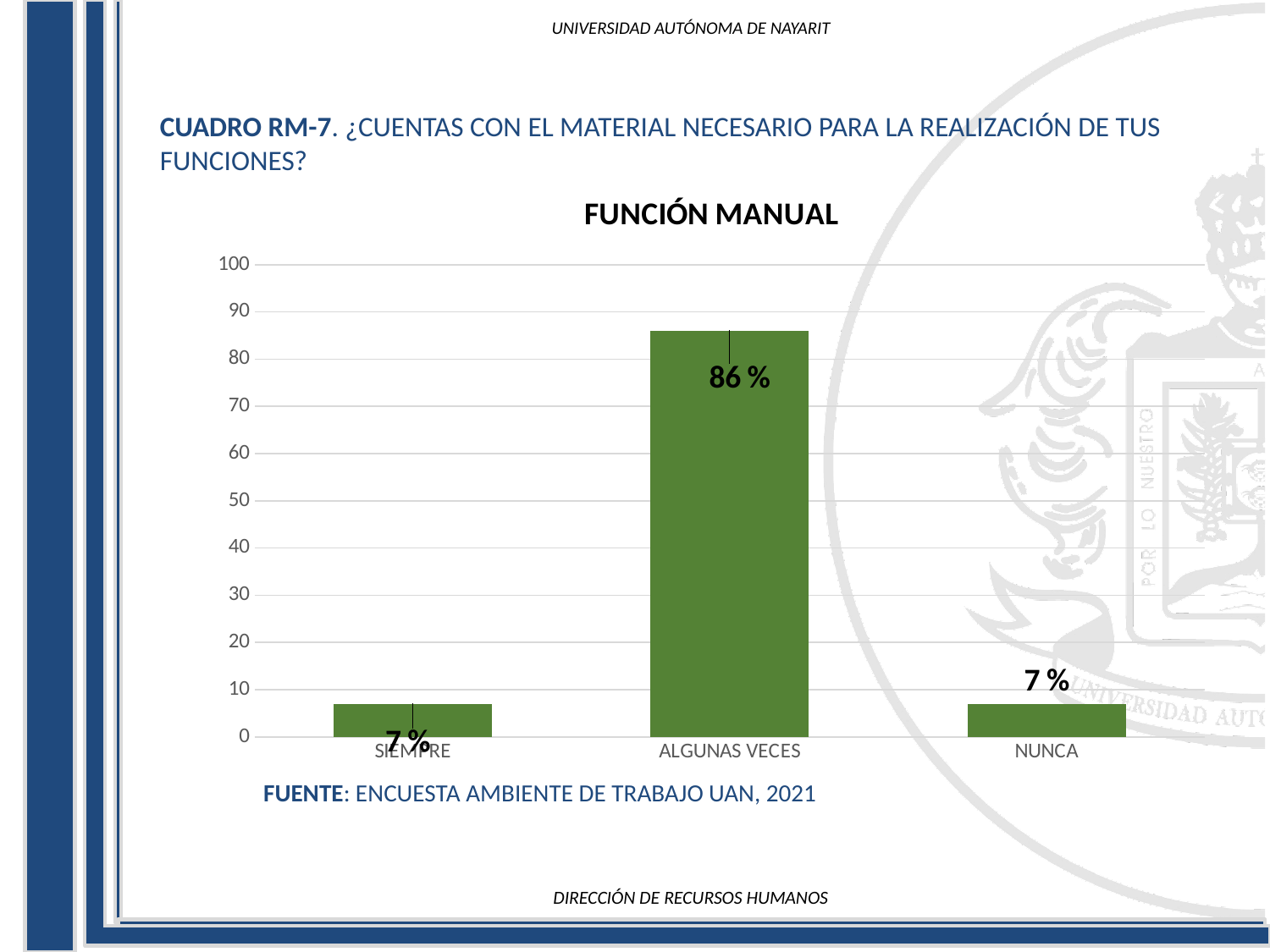
What is the difference between the values for ALGUNAS VECES and NUNCA? 79 % What is the title of the chart? FUNCIÓN MANUAL What is the value for ALGUNAS VECES? 86 % What is the value for NUNCA? 7 % Is the value for NUNCA greater or less than 10? less Is the value for ALGUNAS VECES greater or less than 80? greater What kind of chart is shown on the slide? bar chart Which category has the highest value? ALGUNAS VECES How many categories are shown on the x axis? 3 What is the value for SIEMPRE? 7 % Which is larger, the value for ALGUNAS VECES or the value for SIEMPRE? ALGUNAS VECES What is the highest value shown on the y axis? 100